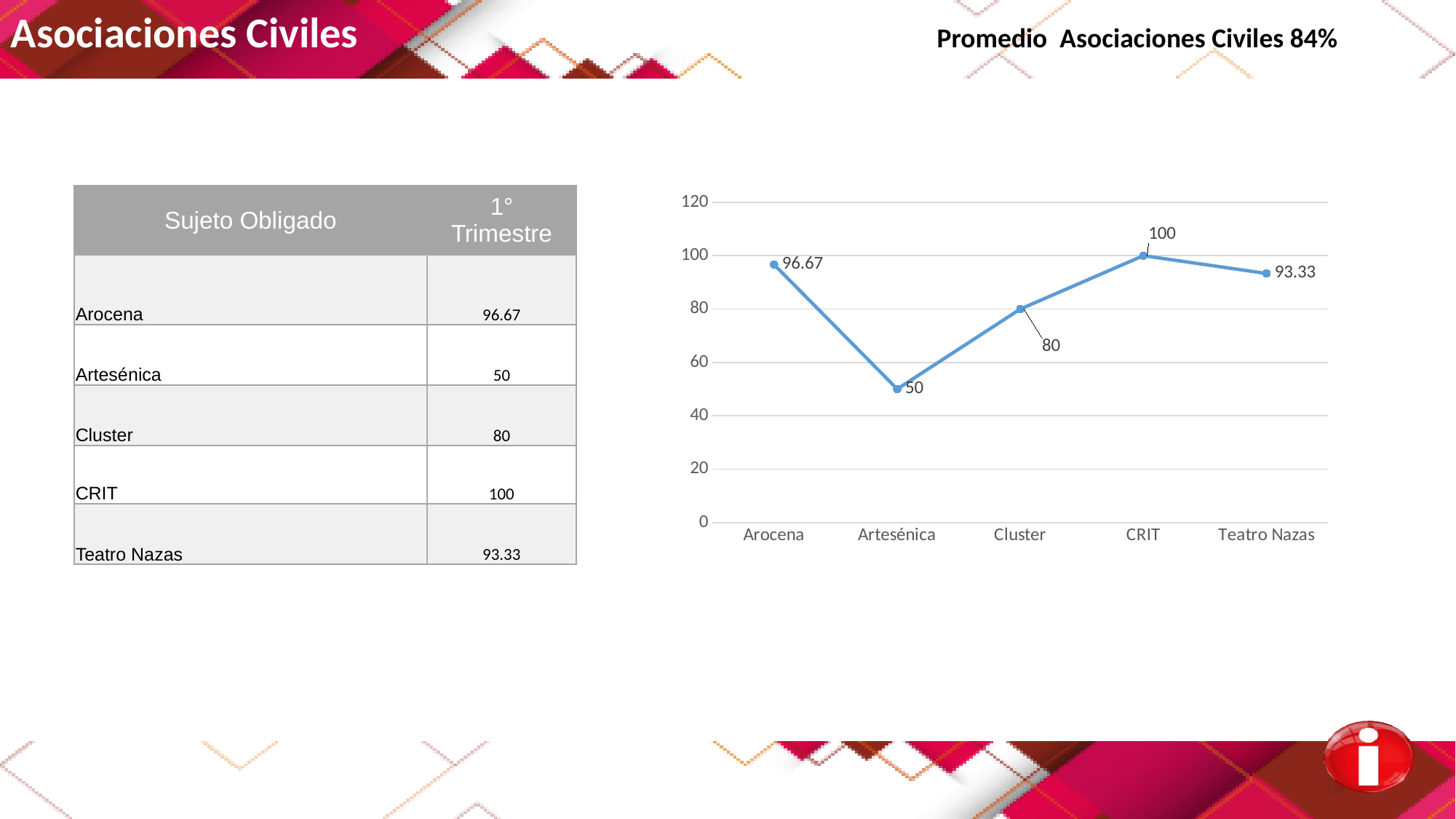
What is the difference between the values for Arocena and Teatro Nazas? 3.34 Which is larger, the value for Cluster or the value for Teatro Nazas? Teatro Nazas Which category has the highest value in the line chart? CRIT Is the value for Cluster greater or less than 100? less What is the value for Teatro Nazas in the line chart? 93.33 What is the value for Artesénica in the line chart? 50 What is the value for Arocena in the line chart? 96.67 Does the line rise or fall from Artesénica to CRIT? rise Which category has the lowest value in the line chart? Artesénica What kind of chart is shown on the slide? line chart What is the difference between the values for CRIT and Cluster? 20 How many categories are plotted on the x axis of the chart? 5